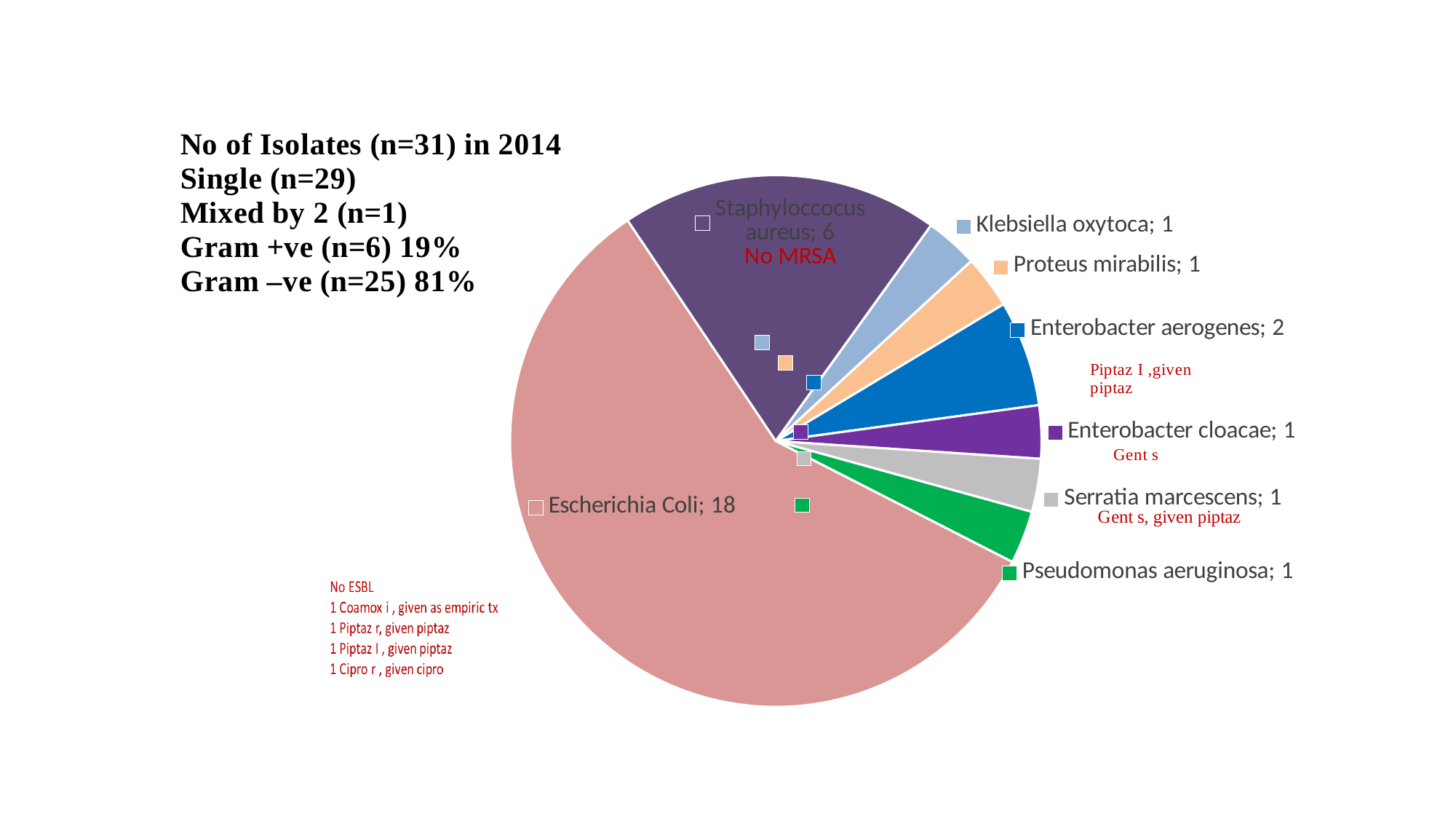
What is the value for Pseudomonas aeruginosa in the pie chart? 1 What is the value for Enterobacter aerogenes in the pie chart? 2 What is the total number of isolates stated in the text on the slide for 2014? 31 What kind of chart is shown on the slide? pie chart What is the value for Escherichia Coli in the pie chart? 18 What is the value for Staphyloccocus aureus in the pie chart? 6 What is the difference between the values for Escherichia Coli and Staphyloccocus aureus? 12 How many slices does the pie chart have? 8 What is the difference between the values for Staphyloccocus aureus and Enterobacter aerogenes? 4 Which is larger, the value for Enterobacter aerogenes or the value for Enterobacter cloacae? Enterobacter aerogenes Which category has the largest slice in the pie chart? Escherichia Coli How many categories in the pie chart have a value of 1? 5